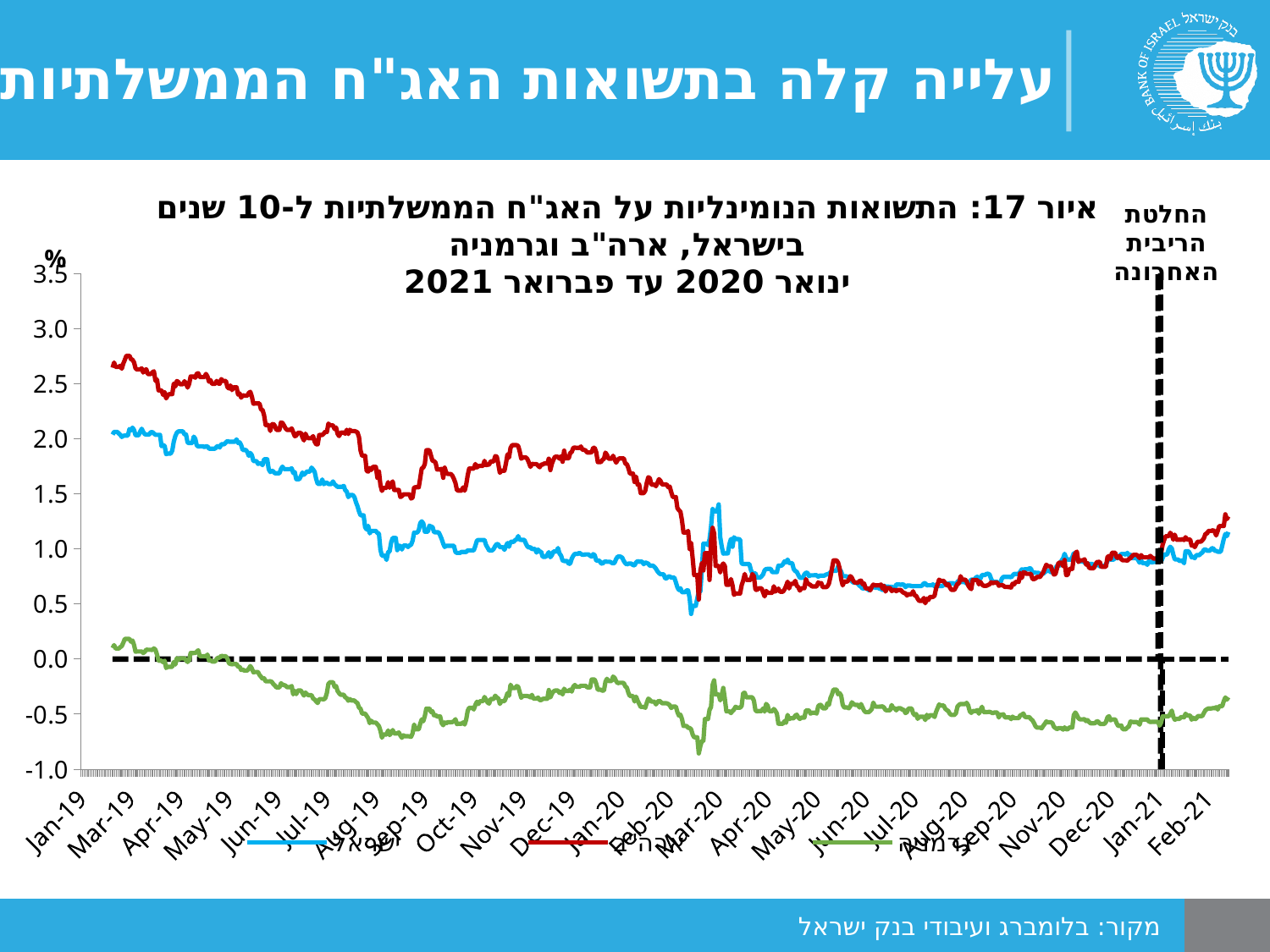
How many series does the legend list? 3 What does the vertical dashed line near Jan-21 mark, according to its label? החלטת הריבית האחרונה Is the value for ארה"ב (US) at Jan-19 greater or less than 2.5? greater Is the value for גרמניה (Germany) at Feb-21 greater or less than 0.0? less What is the highest value shown on the vertical axis? 3.5 Does the yield for ארה"ב (US) rise or fall from Jan-19 to Apr-20? Fall Which series has the highest 10-year yield at the start of the period (Jan-19)? ארה"ב (US) What kind of chart is shown on the slide? Line chart At Jan-19, which is higher: the yield for ישראל (Israel) or for ארה"ב (US)? ארה"ב (US) Which series has the lowest yield throughout the period shown? גרמניה (Germany) Is the value for ארה"ב (US) at Feb-21 greater or less than 1.0? greater